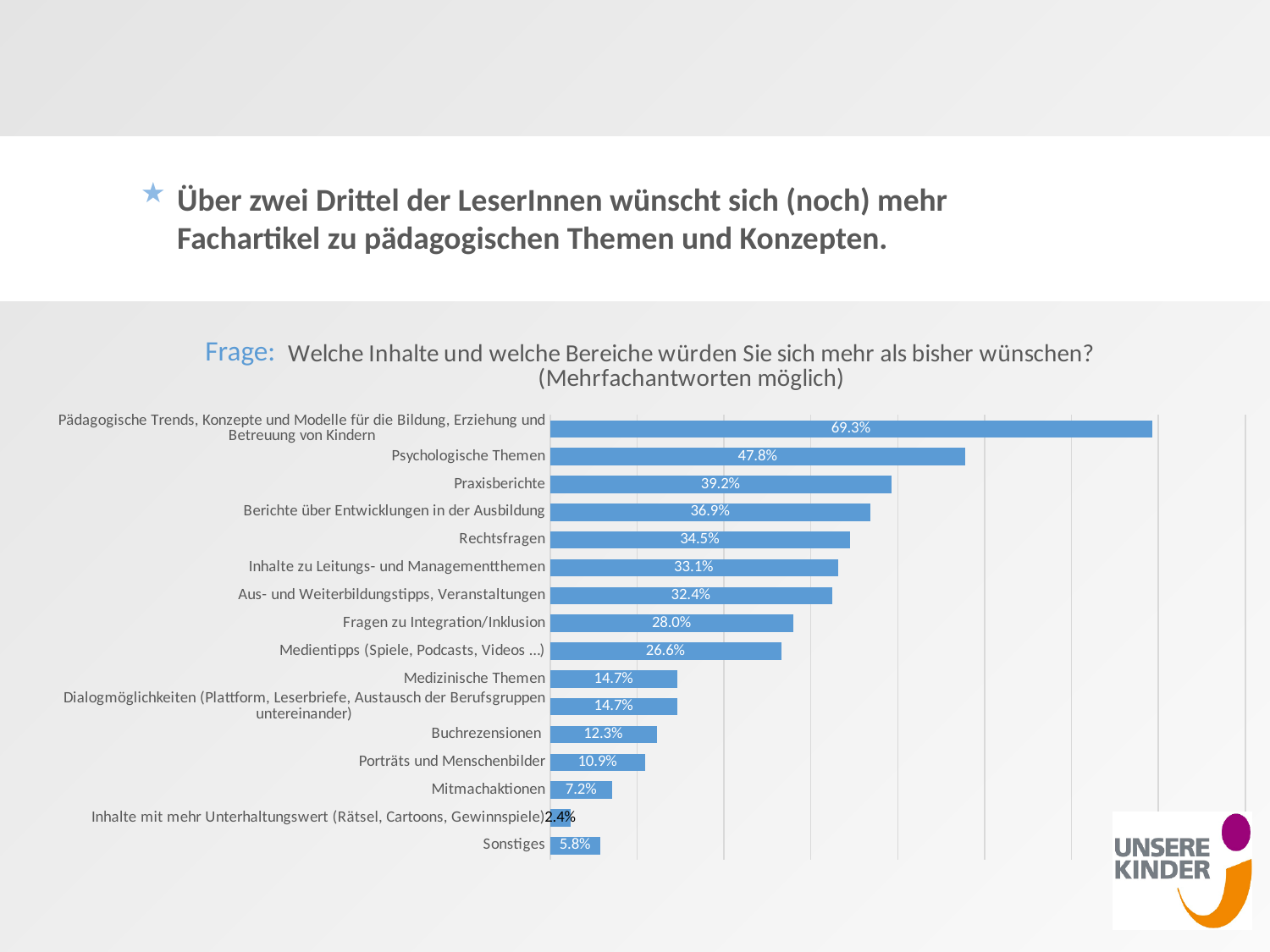
What is the value shown for "Rechtsfragen"? 34.5% Which has a larger value: "Fragen zu Integration/Inklusion" or "Medientipps (Spiele, Podcasts, Videos ...)"? Fragen zu Integration/Inklusion Which category has the lowest value in the chart? Inhalte mit mehr Unterhaltungswert (Rätsel, Cartoons, Gewinnspiele) What is the value shown for "Sonstiges"? 5.8% What is the difference in percentage points between "Praxisberichte" and "Berichte über Entwicklungen in der Ausbildung"? 2.3 percentage points Which category has the highest value in the chart? Pädagogische Trends, Konzepte und Modelle für die Bildung, Erziehung und Betreuung von Kindern How many categories are shown in the bar chart? 16 What question (Frage) is the chart based on, according to the chart title? Welche Inhalte und welche Bereiche würden Sie sich mehr als bisher wünschen? (Mehrfachantworten möglich) What is the value shown for "Mitmachaktionen"? 7.2% What is the difference in percentage points between "Pädagogische Trends, Konzepte und Modelle..." (69.3%) and "Psychologische Themen" (47.8%)? 21.5 percentage points What kind of chart is shown on the slide? Bar chart What percentage of readers wished for more content on "Psychologische Themen"? 47.8%